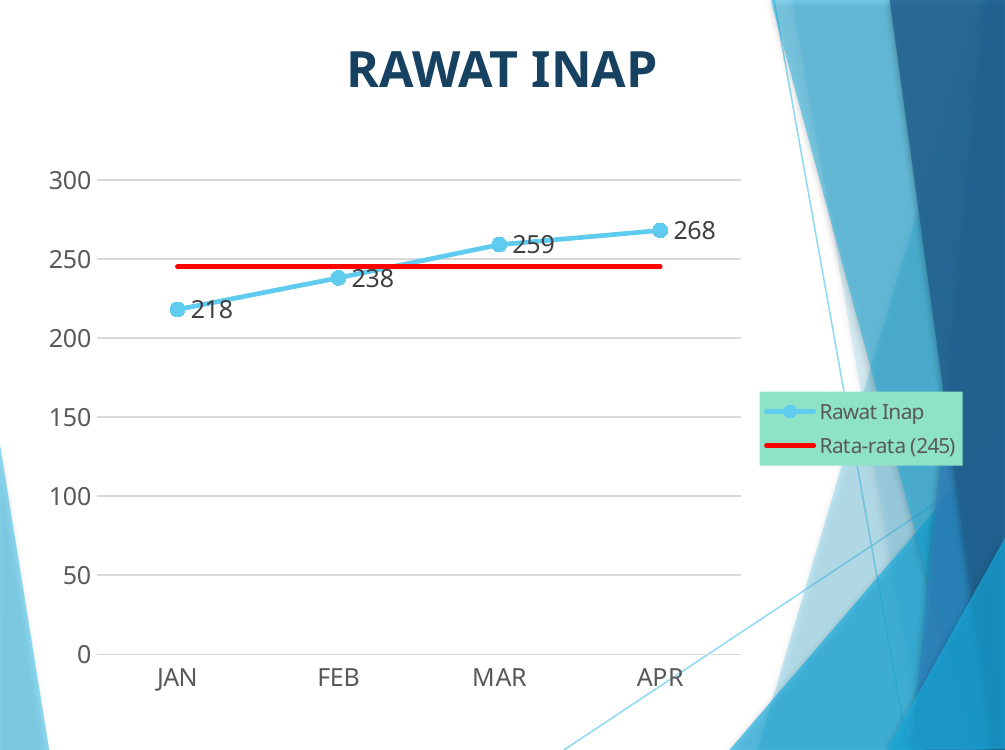
What kind of chart is shown on the slide? line chart Which is larger, the Rawat Inap value for FEB or for MAR? MAR Do the Rawat Inap values rise or fall from JAN to APR? rise How many months are plotted on the x axis? 4 Which month has the lowest Rawat Inap value? JAN Is the Rawat Inap value for FEB greater or less than 250? less What is the difference between the Rawat Inap values for APR and JAN? 50 What is the Rawat Inap value for JAN? 218 How many series does the legend list? 2 What is the Rawat Inap value for MAR? 259 Which month has the highest Rawat Inap value? APR What is the Rawat Inap value for APR? 268